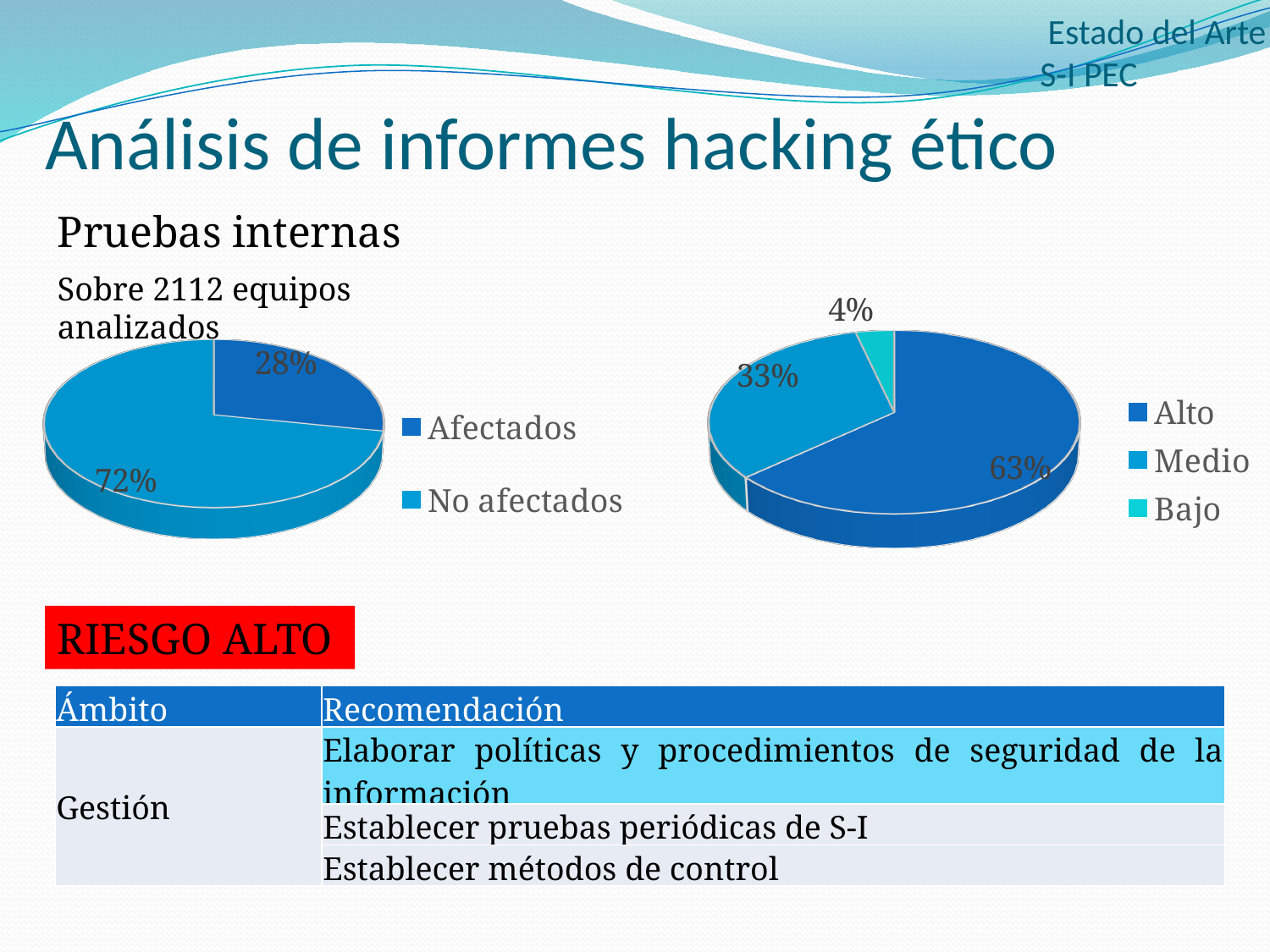
What type of chart is the left chart on the slide? Pie chart In the left pie chart, what percentage is shown for No afectados? 72% In the left pie chart, what is the difference in percentage points between No afectados and Afectados? 44 In the left pie chart, which category has the larger share? No afectados How many categories does the legend of the right pie chart list? 3 In the left pie chart, what percentage is shown for Afectados? 28% In the right pie chart, what percentage is shown for Bajo? 4% In the right pie chart, what percentage is shown for Alto? 63% In the right pie chart, what percentage is shown for Medio? 33% In the right pie chart, which category has the smallest share? Bajo In the right pie chart, which category has the largest share? Alto In the right pie chart, what is the difference in percentage points between Alto and Medio? 30